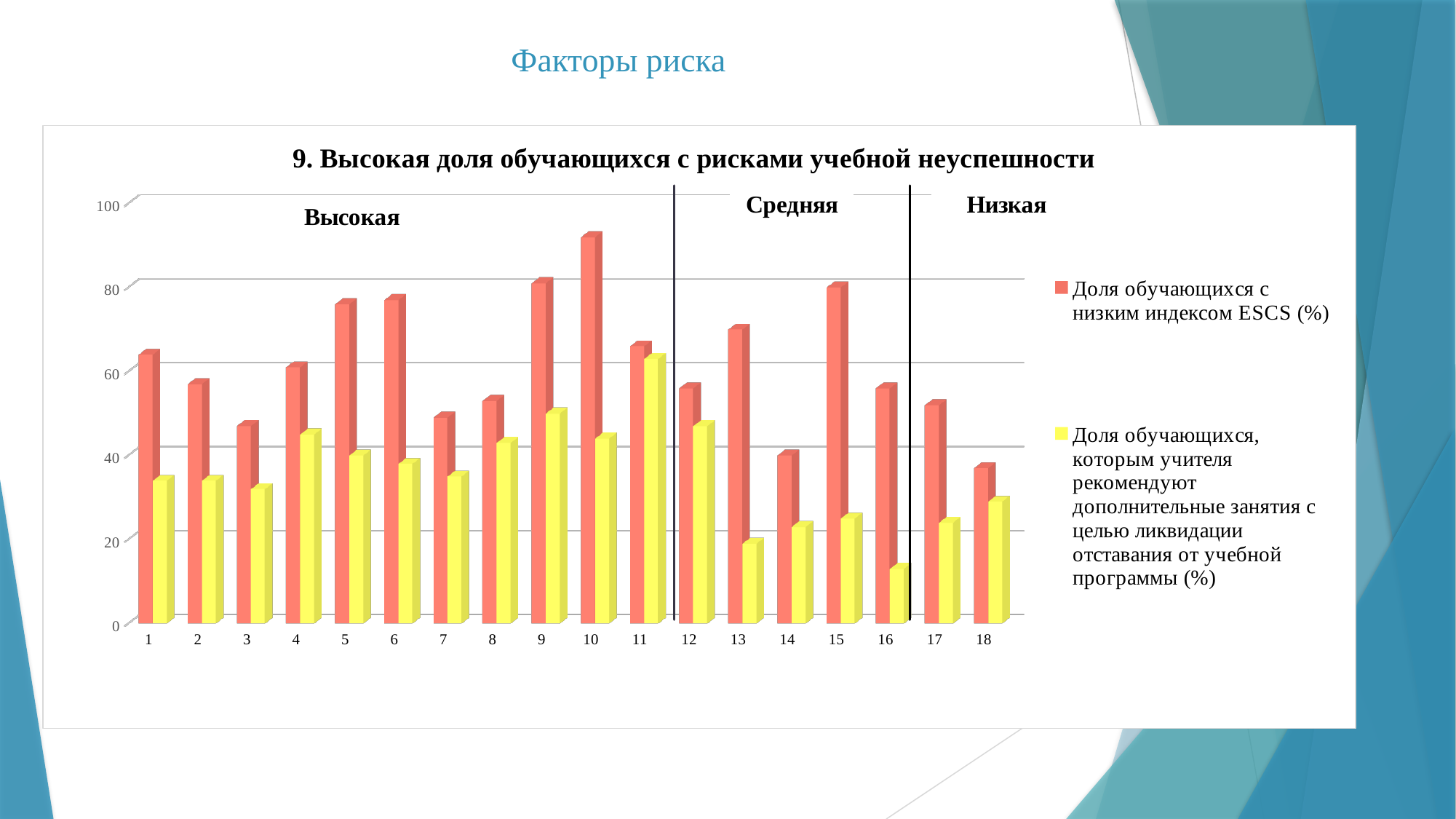
Is the value for 'Доля обучающихся с низким индексом ESCS (%)' at category 3 greater or less than 60? less Which category has the highest value for the yellow series (share of students recommended additional classes)? 11 Which is larger: the yellow bar at category 11 or at category 9? Category 11 How many series does the legend list? 2 What are the three group labels written above the bars in the chart? Высокая, Средняя, Низкая Which category has the lowest value for the yellow series (share of students recommended additional classes)? 16 Which is larger: the red bar (low ESCS index) at category 13 or at category 12? Category 13 Which category has the highest value for 'Доля обучающихся с низким индексом ESCS (%)'? 10 What kind of chart is shown on the slide? Bar chart Is the value for 'Доля обучающихся с низким индексом ESCS (%)' at category 10 greater or less than 80? greater How many categories are shown along the x axis? 18 Is the value of the yellow series at category 16 greater or less than 20? less